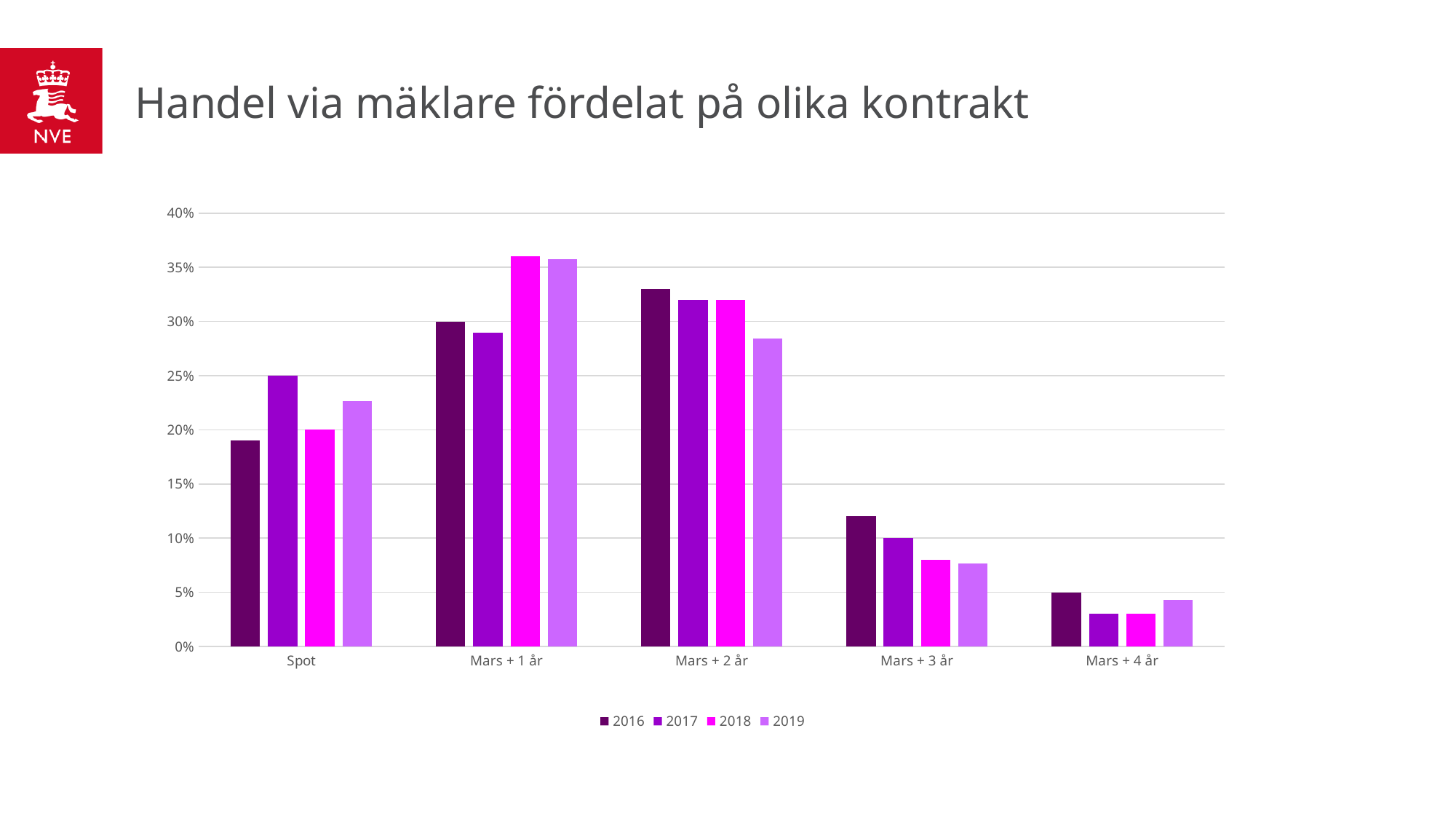
What kind of chart is shown on the slide? bar chart What is the title of the chart? Handel via mäklare fördelat på olika kontrakt Is the value for 2018 in the Mars + 1 år category greater or less than 35%? greater Which category has the highest value for 2018? Mars + 1 år What is the value for 2017 in the Spot category? 25% What is the value for 2016 in the Mars + 1 år category? 30% How many series does the legend list? 4 How many categories are shown on the x axis? 5 Which is larger in the Mars + 3 år category, the value for 2016 or the value for 2019? 2016 What is the value for 2016 in the Mars + 4 år category? 5% Is the value for 2019 in the Mars + 2 år category greater or less than 30%? less Which category has the lowest value for 2019? Mars + 4 år